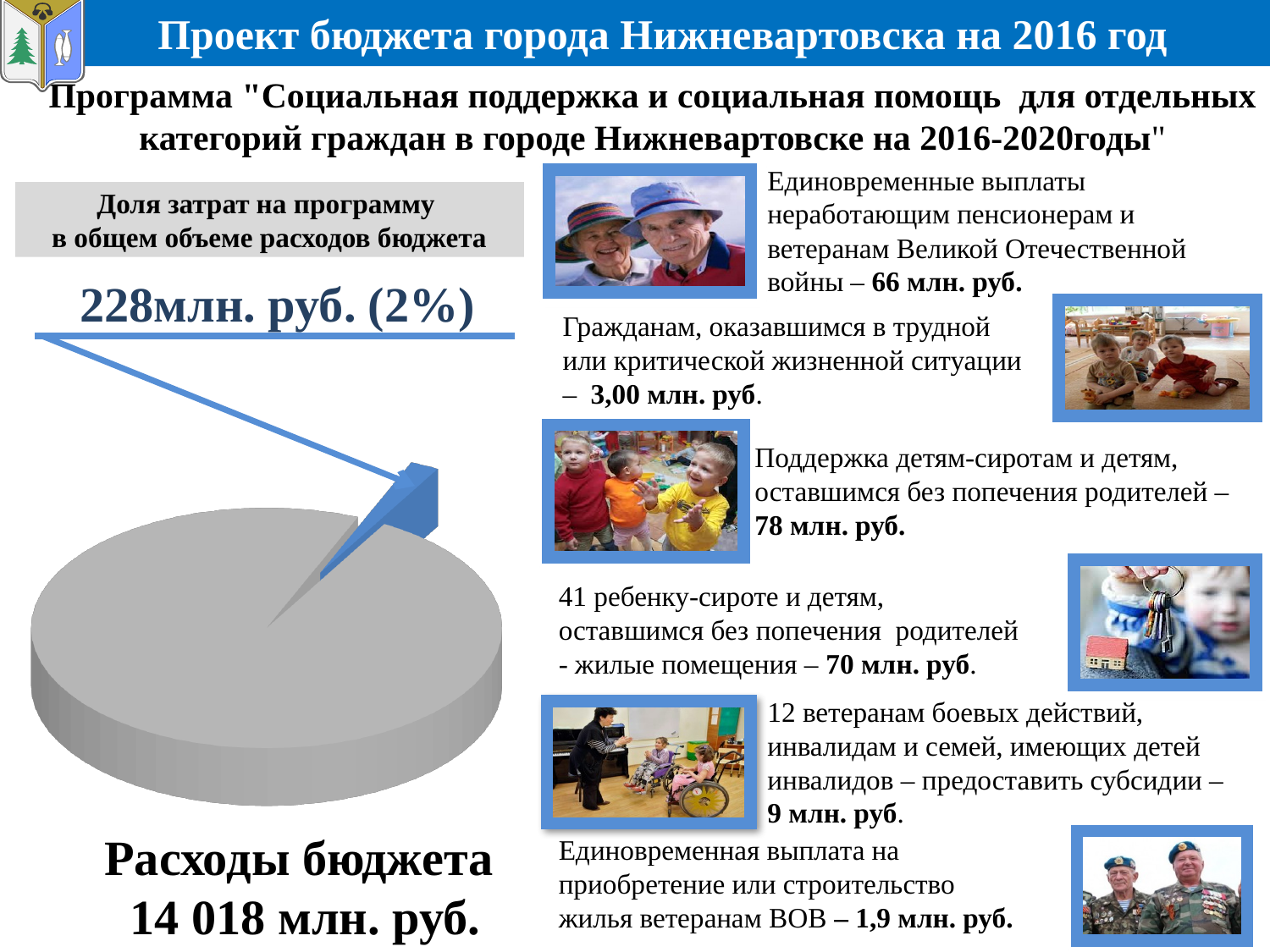
How many slices does the pie chart have? 2 What colour is the exploded slice representing the program expenditures in the pie chart? blue What share of total budget expenditures does the program account for, according to the pie chart? 2% What is the total budget expenditure shown below the pie chart? 14 018 млн. руб. What is the title of the pie chart? Доля затрат на программу в общем объеме расходов бюджета What kind of chart is shown on the left of the slide? pie chart Is the program's share of the budget shown in the pie chart greater or less than 50%? less What is the amount of program expenditures highlighted in the pie chart? 228 млн. руб. Which slice of the pie chart is larger: the program expenditures slice or the rest of the budget expenditures? the rest of the budget expenditures What is the difference between total budget expenditures (14 018 млн. руб.) and program expenditures (228 млн. руб.)? 13 790 млн. руб.